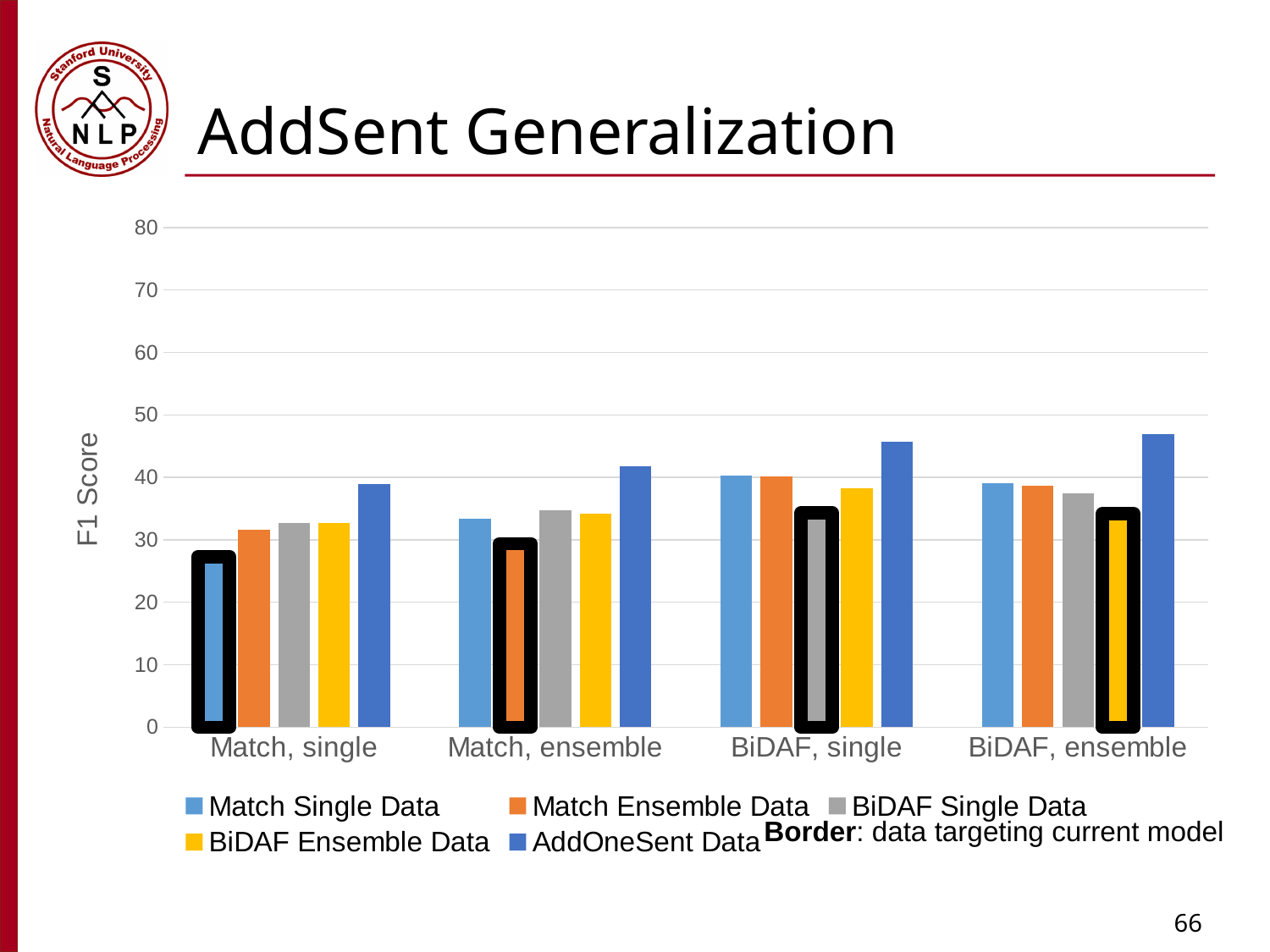
Is the value for BiDAF Single Data in the 'BiDAF, single' category greater or less than 40? less For the 'BiDAF, ensemble' category, which series has the lowest F1 Score? BiDAF Ensemble Data Which is larger: the AddOneSent Data value for 'BiDAF, ensemble' or the AddOneSent Data value for 'Match, single'? BiDAF, ensemble What kind of chart is shown on the slide? bar chart Is the value for Match Single Data in the 'Match, single' category greater or less than 30? less What is the label on the y axis of the chart? F1 Score Is the value for AddOneSent Data in the 'BiDAF, ensemble' category greater or less than 40? greater How many series does the chart's legend list? 5 Does the AddOneSent Data series rise or fall moving from 'Match, single' to 'BiDAF, ensemble' along the x axis? rise For the 'Match, single' category, which series has the highest F1 Score? AddOneSent Data For the 'Match, single' category, which series has the lowest F1 Score? Match Single Data How many categories are shown on the x axis of the chart? 4